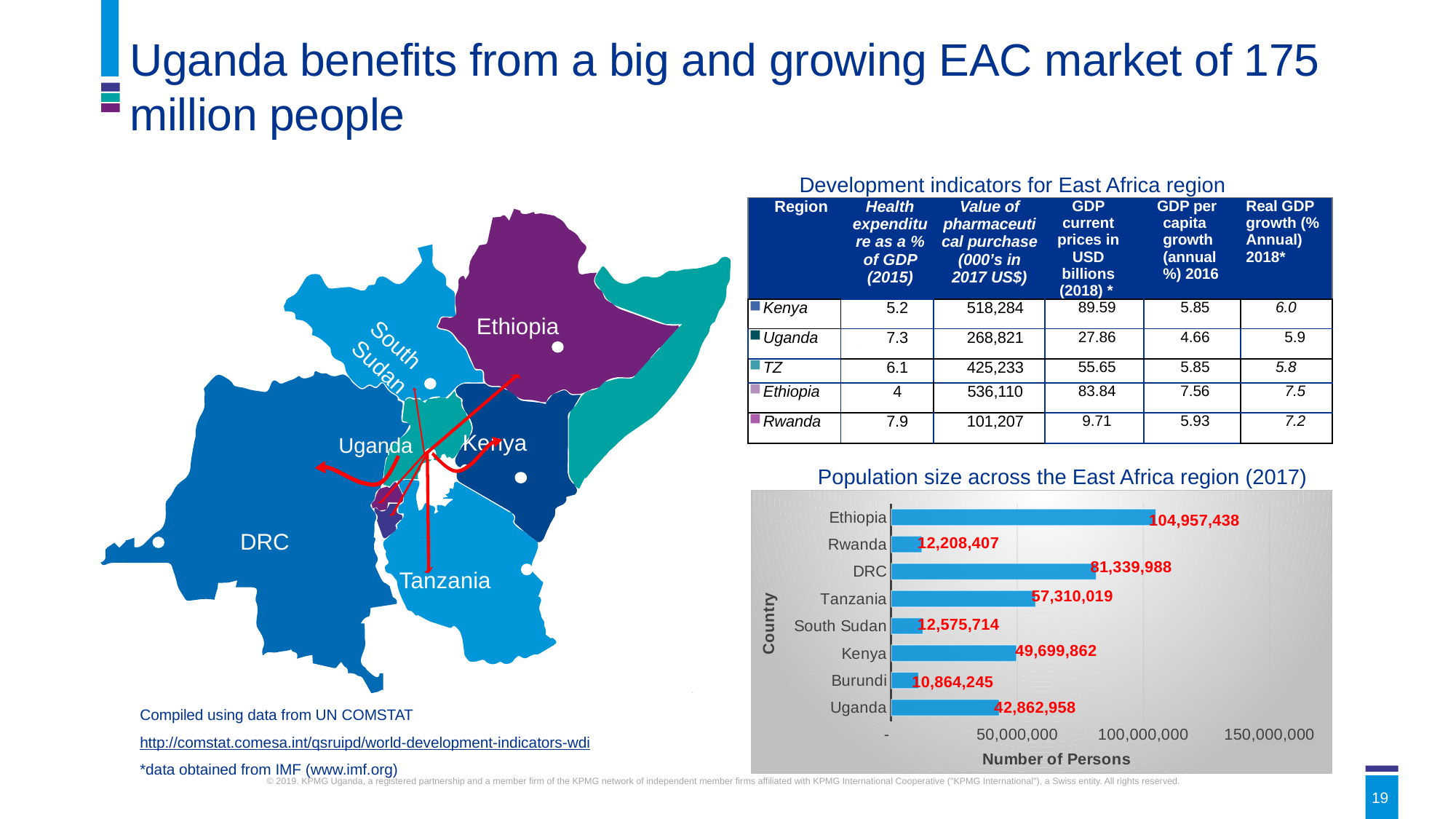
What is the population of Uganda shown in the bar chart? 42,862,958 What is the population of Tanzania shown in the bar chart? 57,310,019 What is the difference in population between Kenya and Uganda in the bar chart? 6,836,904 Is the population value for Ethiopia greater or less than 100,000,000? greater What is the population of Ethiopia shown in the bar chart? 104,957,438 What kind of chart is used to show population size across the East Africa region? bar chart Which country has the smallest population in the bar chart? Burundi Which has a larger population in the bar chart, Kenya or Uganda? Kenya What is the x-axis title of the population bar chart? Number of Persons Which country has the largest population in the bar chart? Ethiopia How many countries are shown in the bar chart? 8 What is the difference in population between Ethiopia and DRC in the bar chart? 23,617,450